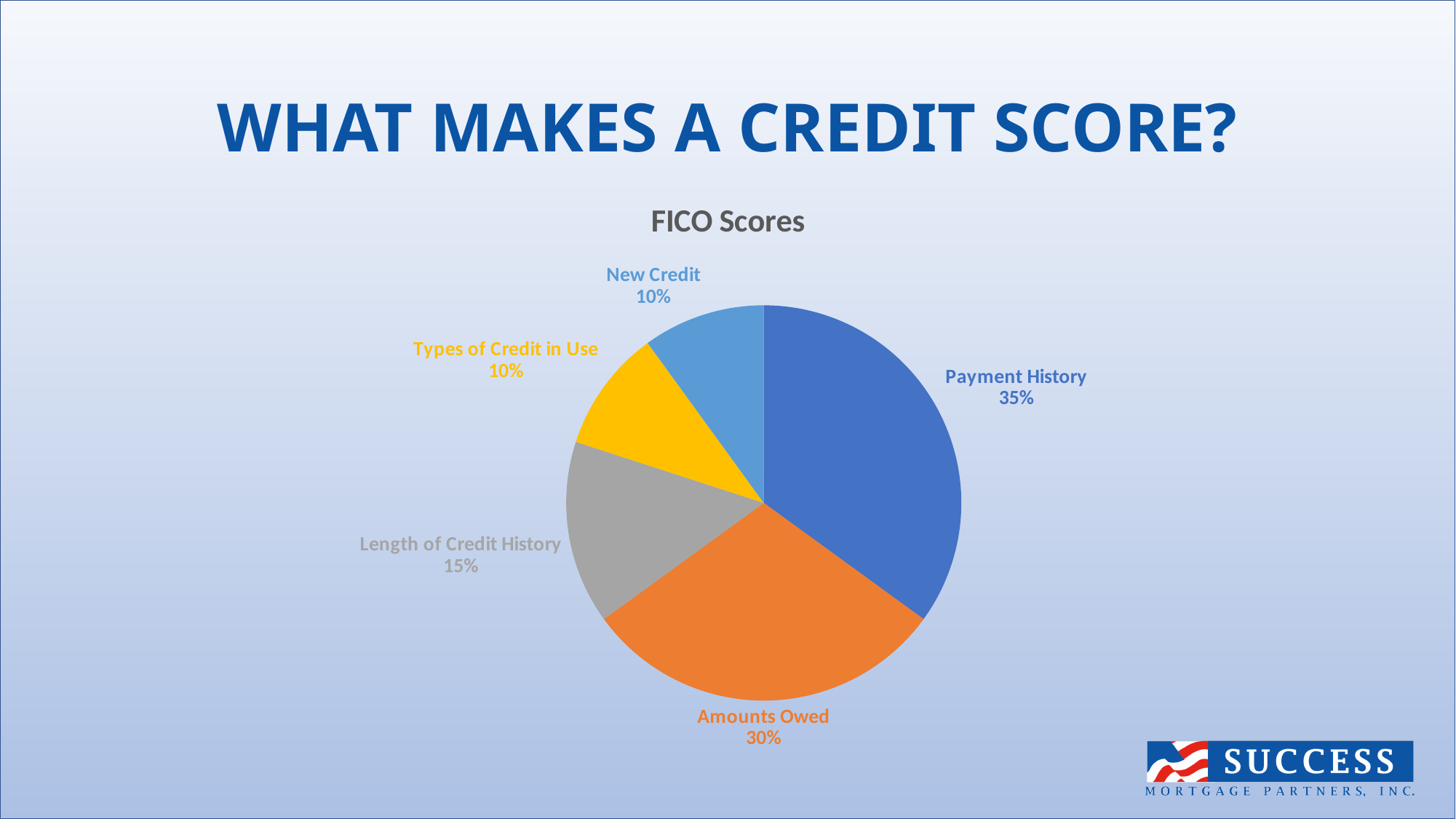
Which is larger, the share for Length of Credit History or the share for Types of Credit in Use? Length of Credit History What is the combined share of New Credit and Types of Credit in Use? 20% What share of the pie does New Credit represent? 10% What share of the pie does Length of Credit History represent? 15% What share of the pie does Amounts Owed represent? 30% How many slices does the pie chart have? 5 What share of the pie does Payment History represent? 35% Which category has the largest share of the pie? Payment History What colour is the Amounts Owed slice? Orange What is the title of the chart? FICO Scores What is the difference between the shares of Payment History and Amounts Owed? 5% What type of chart is shown on the slide? Pie chart